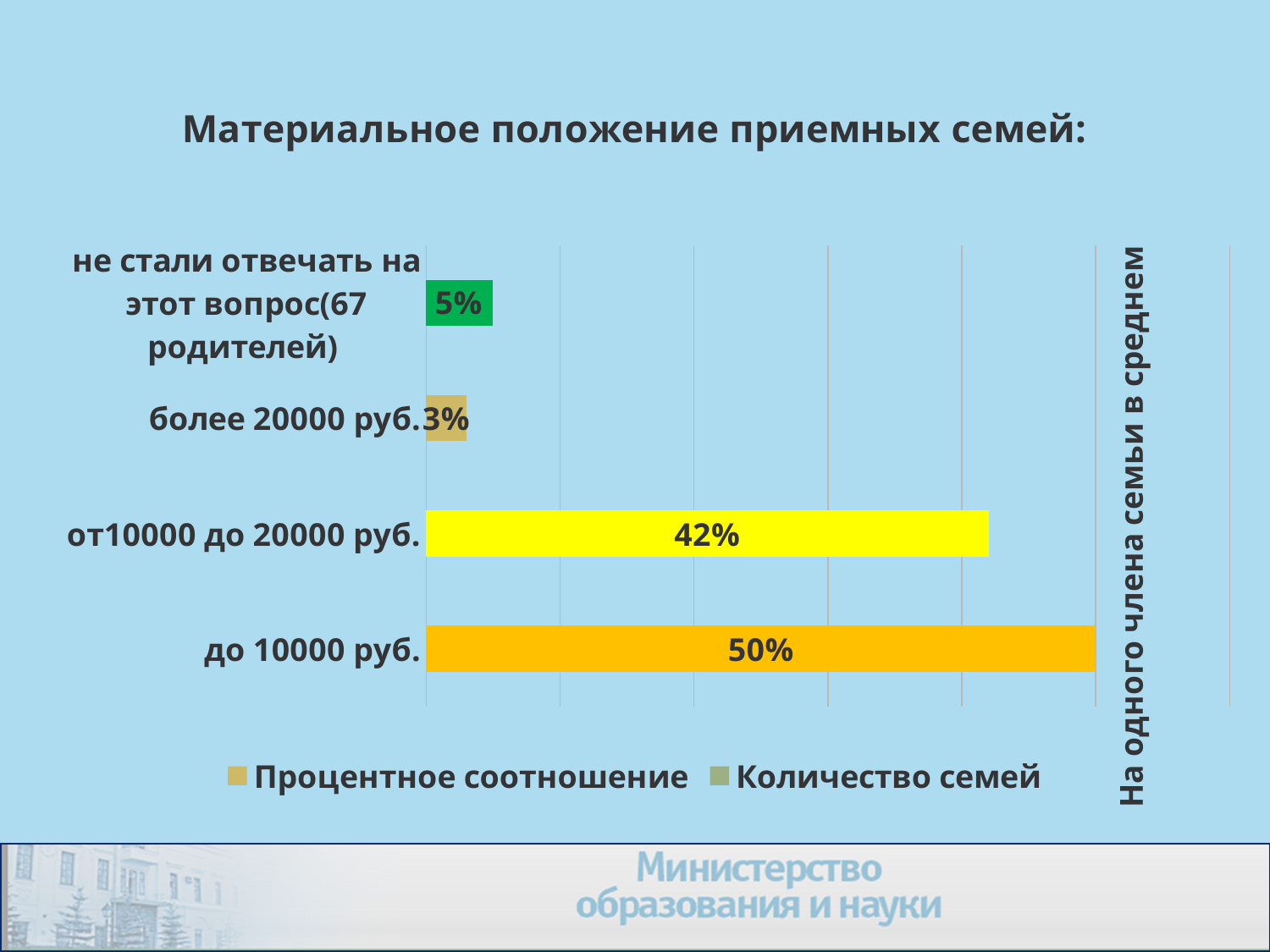
Which category has the highest value? до 10000 руб. What is the difference between the values for "до 10000 руб." and "от10000 до 20000 руб."? 8% What is the value for the category "не стали отвечать на этот вопрос(67 родителей)"? 5% Which is larger: the value for "не стали отвечать на этот вопрос(67 родителей)" or the value for "более 20000 руб."? не стали отвечать на этот вопрос(67 родителей) How many series does the legend list? 2 What kind of chart is shown on the slide? Bar chart What is the value for the category "от10000 до 20000 руб."? 42% Which category has the lowest value? более 20000 руб. What is the title of the chart? Материальное положение приемных семей: What is the value for the category "до 10000 руб."? 50% How many categories are shown in the chart? 4 What is the value for the category "более 20000 руб."? 3%